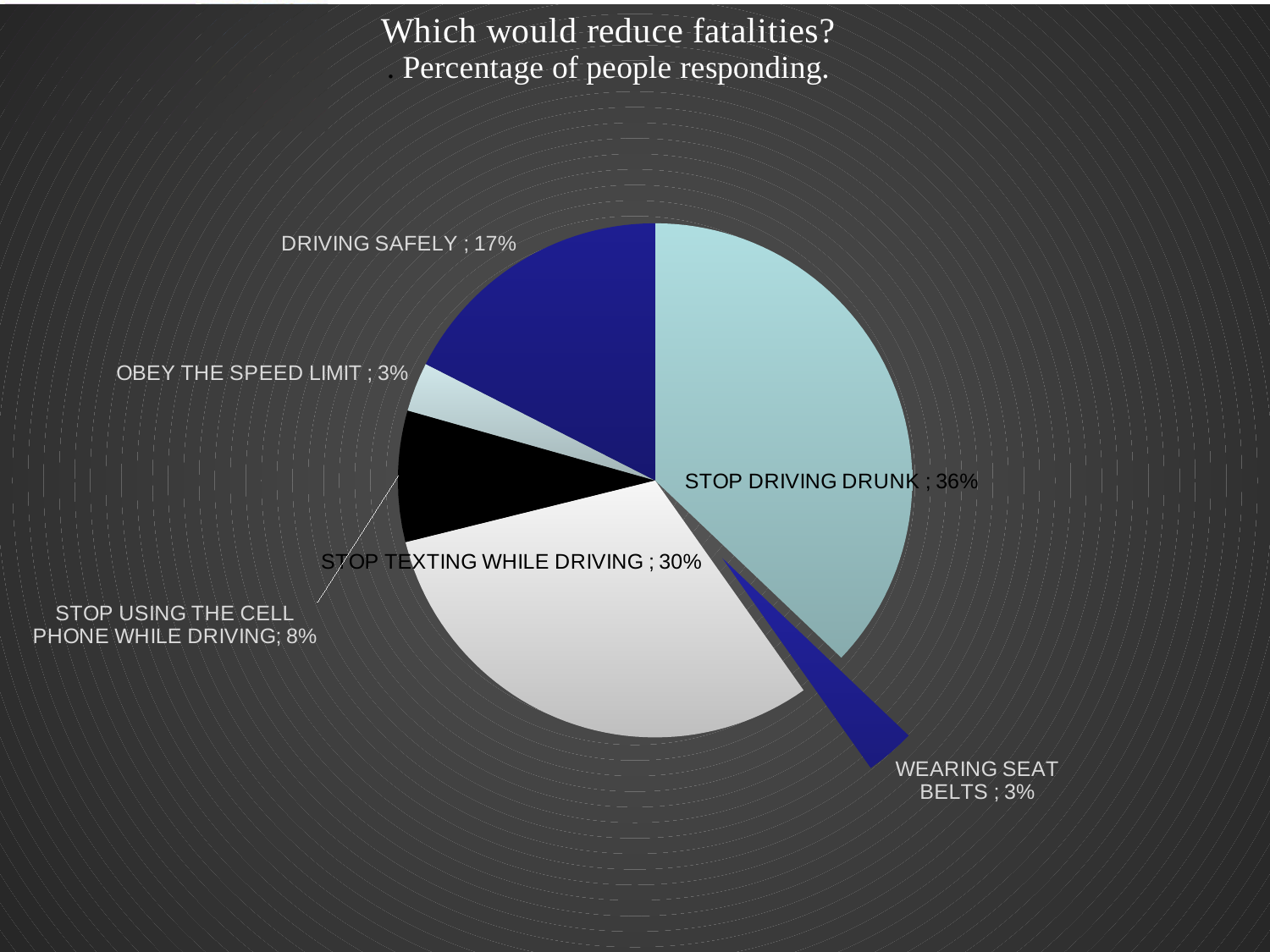
Which is larger: the share for 'Driving safely' or the share for 'Stop using the cell phone while driving'? Driving safely What percentage of people responded with 'Driving safely'? 17% What percentage of people responded with 'Stop driving drunk'? 36% What is the difference in percentage points between 'Driving safely' and 'Obey the speed limit'? 14 What is the title of the chart? Which would reduce fatalities? Percentage of people responding. How many categories are shown in the pie chart? 6 What kind of chart is shown on the slide? Pie chart What is the difference in percentage points between 'Stop driving drunk' and 'Stop texting while driving'? 6 Which response has the largest share of the pie? Stop driving drunk What percentage of people responded with 'Stop texting while driving'? 30% What percentage of people responded with 'Wearing seat belts'? 3% What percentage of people responded with 'Stop using the cell phone while driving'? 8%